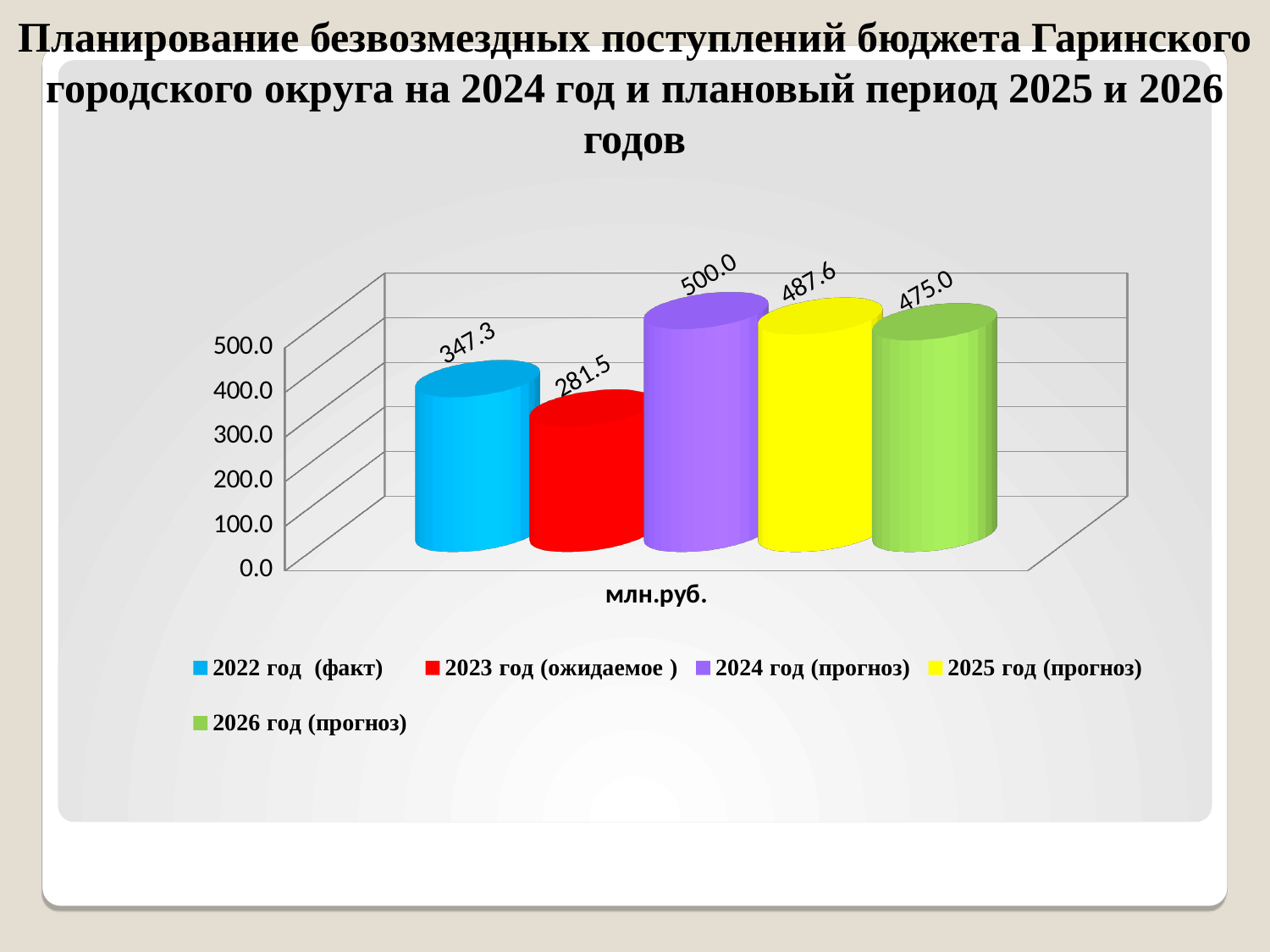
What is the value for 2024 год (прогноз)? 500.0 Which series has the highest value? 2024 год (прогноз) What is the value for 2022 год (факт)? 347.3 What unit label is shown under the chart's category axis? млн.руб. How many series does the legend list? 5 What is the value for 2023 год (ожидаемое)? 281.5 Which series has the lowest value? 2023 год (ожидаемое) What is the difference between the values for 2024 год (прогноз) and 2025 год (прогноз)? 12.4 What is the difference between the values for 2022 год (факт) and 2023 год (ожидаемое)? 65.8 What kind of chart is shown on the slide? bar chart Which is larger, the value for 2025 год (прогноз) or the value for 2026 год (прогноз)? 2025 год (прогноз) What is the value for 2026 год (прогноз)? 475.0